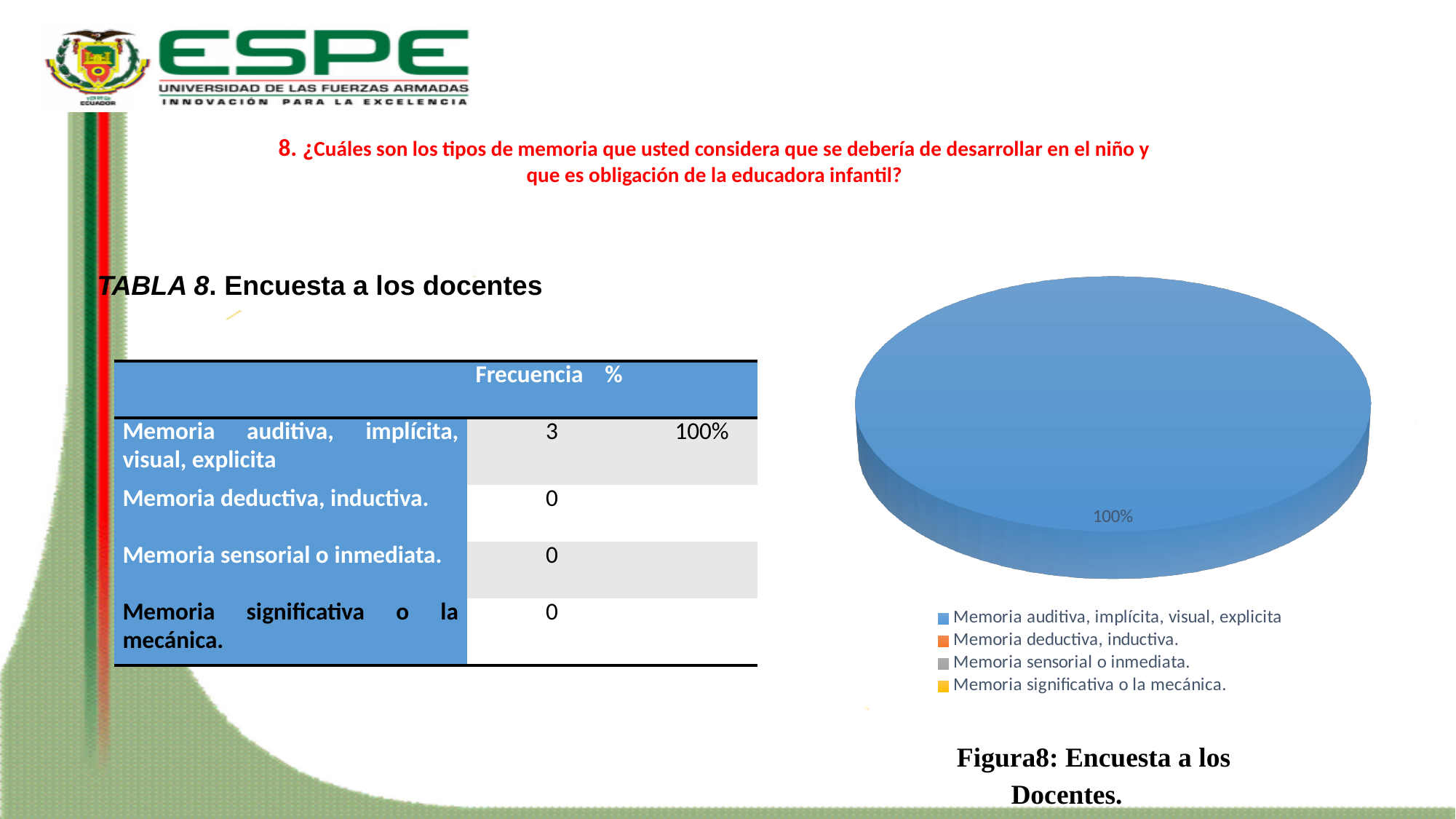
What kind of chart is shown on the slide? pie chart Which is larger in the pie chart: the share for 'Memoria auditiva, implícita, visual, explicita' or the share for 'Memoria deductiva, inductiva.'? Memoria auditiva, implícita, visual, explicita Which category has the largest share in the pie chart? Memoria auditiva, implícita, visual, explicita What is the only data label printed on the pie chart? 100% Is the share for 'Memoria auditiva, implícita, visual, explicita' in the pie chart greater or less than 50%? greater Which legend entry is shown in blue in the pie chart? Memoria auditiva, implícita, visual, explicita What is the caption of the pie chart figure? Figura8: Encuesta a los Docentes. How many visible slices does the pie chart have? 1 How many entries does the legend of the pie chart list? 4 What share of the pie chart does 'Memoria auditiva, implícita, visual, explicita' take? 100%